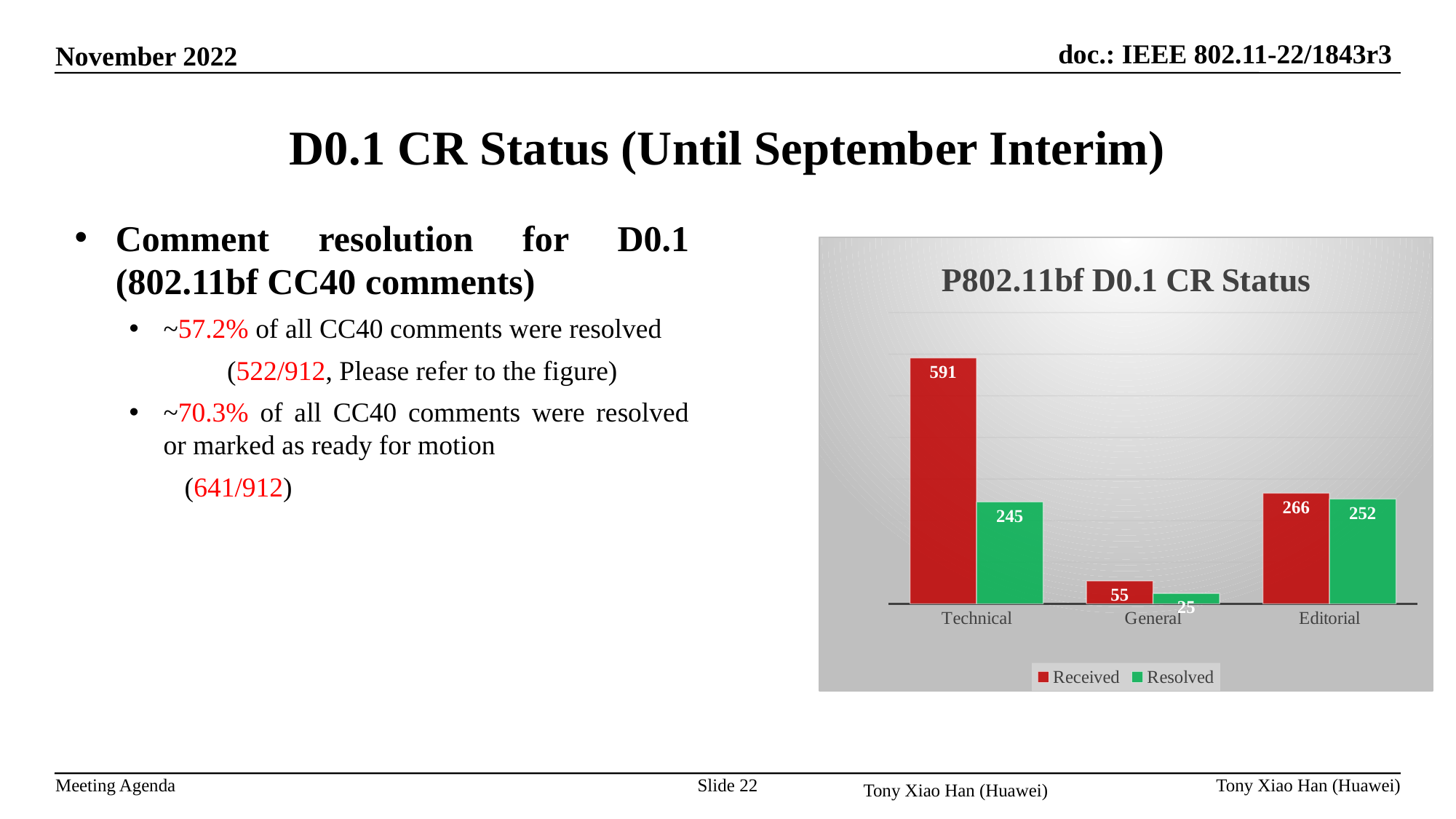
What is the title of the chart? P802.11bf D0.1 CR Status What type of chart is shown on the slide? bar chart What is the Received value for Technical? 591 Which is larger, the Received value for Editorial or the Resolved value for Technical? Received value for Editorial Which category has the lowest Resolved value? General Which category has the highest Received value? Technical How many series does the legend list? 2 What is the Resolved value for Editorial? 252 How many categories are shown on the x axis? 3 What is the difference between Received and Resolved for Technical? 346 What colour represents the Resolved series? green What is the Resolved value for General? 25